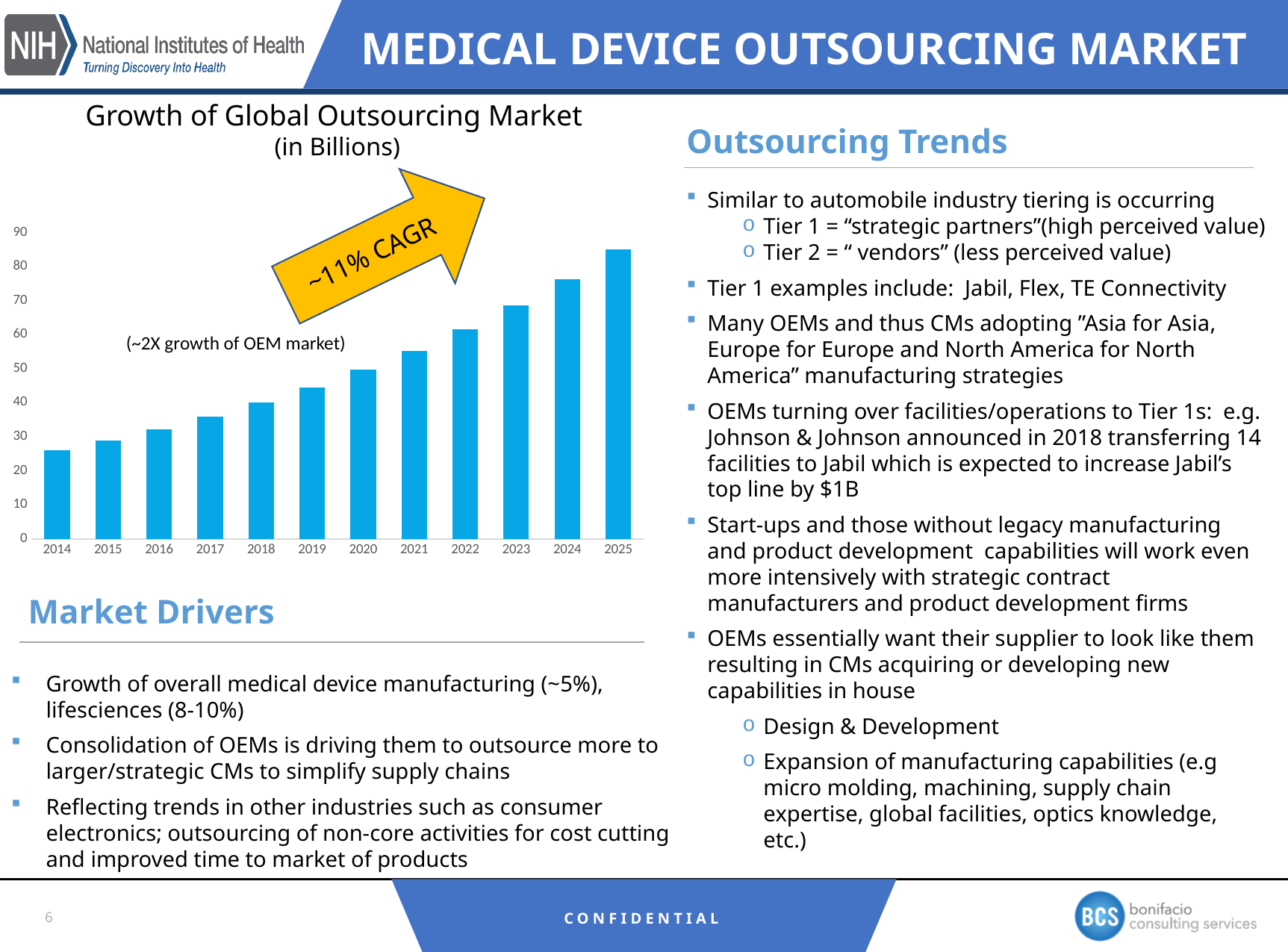
Is the value for 2025 on the Growth of Global Outsourcing Market chart greater or less than 80? greater What kind of chart is used to show the Growth of Global Outsourcing Market? bar chart On the Growth of Global Outsourcing Market chart, which is larger, the value for 2018 or the value for 2022? 2022 Is the value for 2014 on the Growth of Global Outsourcing Market chart greater or less than 30? less What CAGR is shown in the arrow annotation on the Growth of Global Outsourcing Market chart? ~11% CAGR Is the value for 2020 on the Growth of Global Outsourcing Market chart greater or less than 60? less Do the values on the Growth of Global Outsourcing Market chart rise or fall from 2014 to 2025? rise How many years are plotted on the Growth of Global Outsourcing Market chart? 12 Which year has the lowest value on the Growth of Global Outsourcing Market chart? 2014 Which year has the highest value on the Growth of Global Outsourcing Market chart? 2025 What unit is stated in the subtitle of the Growth of Global Outsourcing Market chart? in Billions